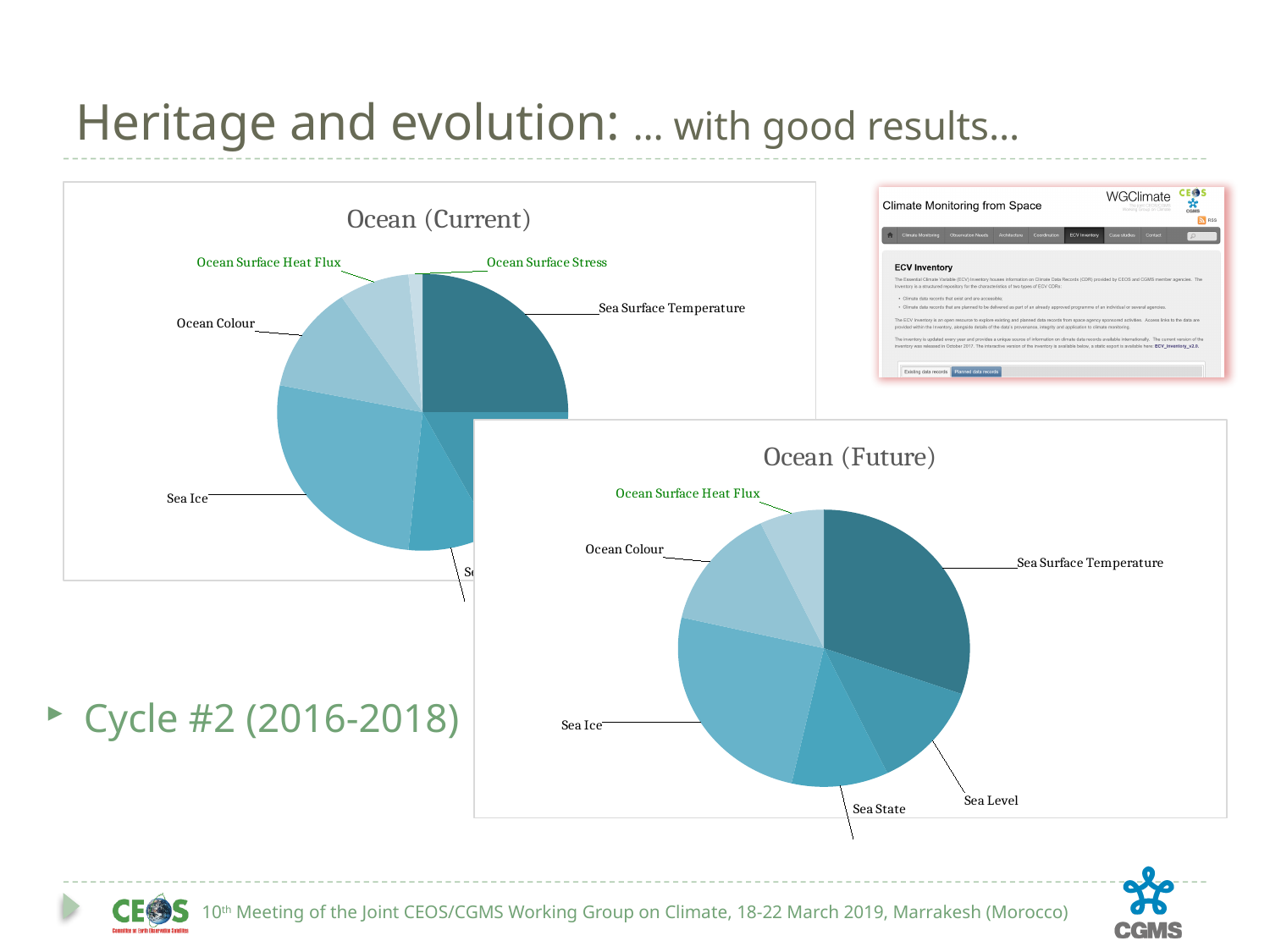
What kind of chart is the "Ocean (Future)" chart? Pie chart Which category is labelled in the "Ocean (Current)" chart but does not appear in the "Ocean (Future)" chart? Ocean Surface Stress In the "Ocean (Future)" chart, which category has the smallest slice? Ocean Surface Heat Flux In the "Ocean (Current)" chart, which slice is larger: Sea Surface Temperature or Ocean Surface Heat Flux? Sea Surface Temperature In the "Ocean (Future)" chart, which slice is larger: Sea Surface Temperature or Sea Level? Sea Surface Temperature In the "Ocean (Current)" chart, which category has the smallest slice? Ocean Surface Stress What kind of chart is the "Ocean (Current)" chart? Pie chart What is the title of the pie chart in the lower right of the slide? Ocean (Future) In the "Ocean (Future)" chart, which category has the largest slice? Sea Surface Temperature In the "Ocean (Future)" chart, which slice is larger: Sea Ice or Ocean Colour? Sea Ice How many categories are shown in the "Ocean (Future)" pie chart? 6